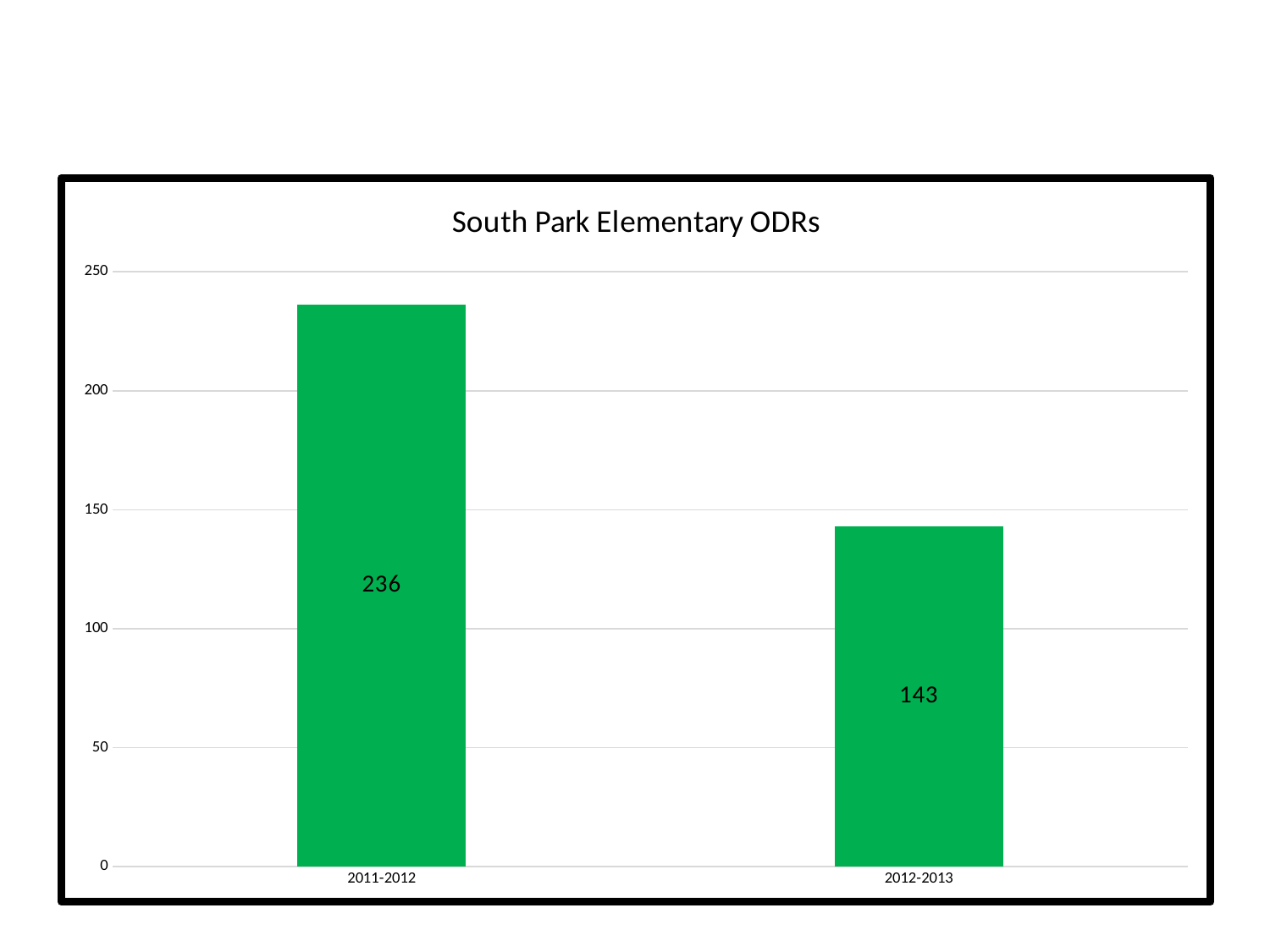
What is the value for 2011-2012? 236 Is the value for 2011-2012 greater or less than 200? greater Which year has the highest value? 2011-2012 Do the values rise or fall from 2011-2012 to 2012-2013? fall How many categories are shown on the x axis? 2 What is the value for 2012-2013? 143 What is the difference between the values for 2011-2012 and 2012-2013? 93 Which is larger, the value for 2011-2012 or the value for 2012-2013? 2011-2012 What kind of chart is shown? bar chart Which year has the lowest value? 2012-2013 What is the title of the chart? South Park Elementary ODRs Is the value for 2012-2013 greater or less than 150? less